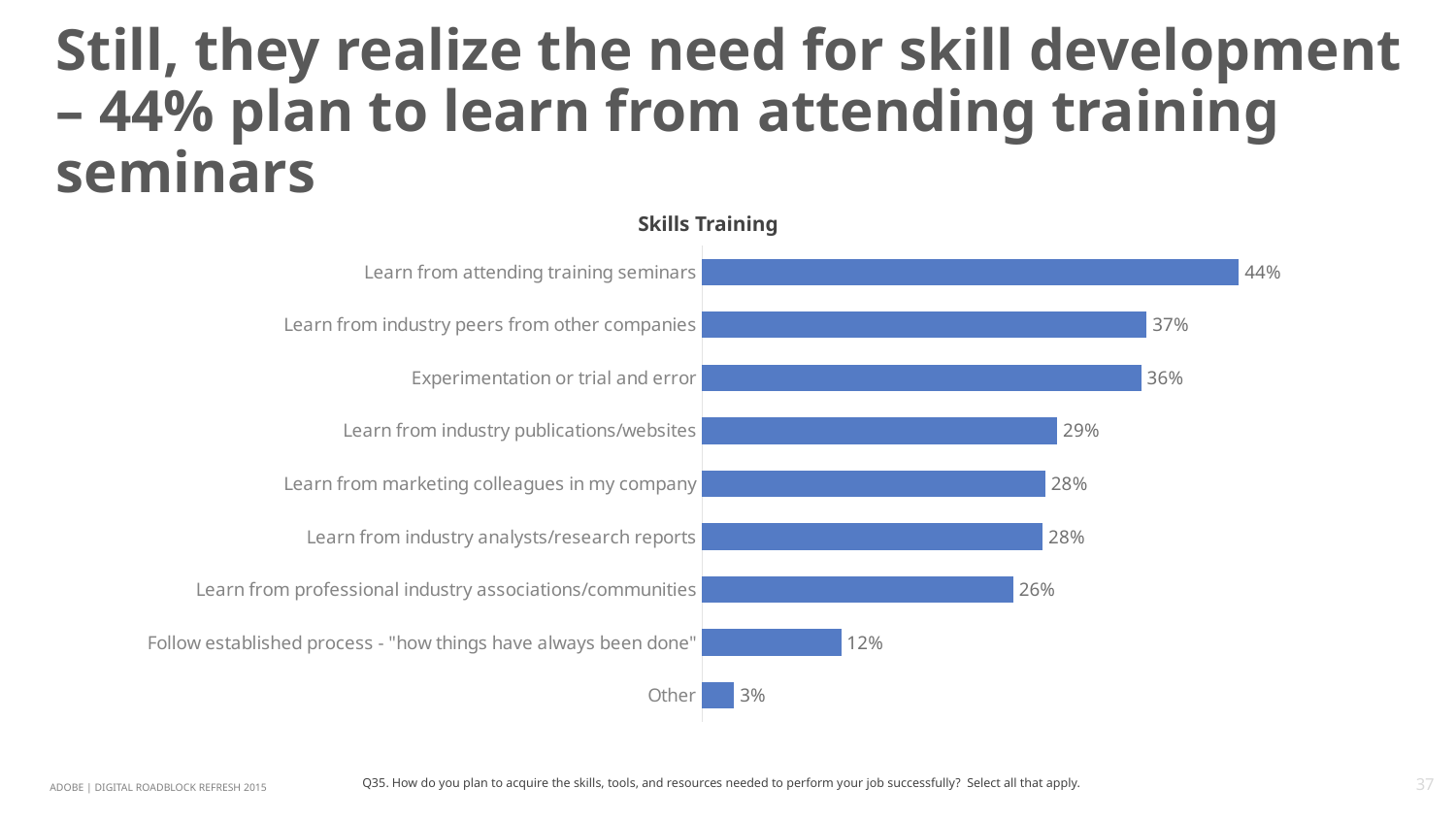
What is the value for "Follow established process - "how things have always been done""? 12% What is the title of the chart? Skills Training What is the difference between "Learn from industry publications/websites" and "Other"? 26% How many categories are shown in the chart? 9 Which two categories both have a value of 28%? Learn from marketing colleagues in my company; Learn from industry analysts/research reports What is the difference between "Learn from attending training seminars" and "Learn from industry peers from other companies"? 7% What percentage plan to learn from attending training seminars? 44% Which is larger: "Learn from industry publications/websites" or "Learn from professional industry associations/communities"? Learn from industry publications/websites Which category has the highest value? Learn from attending training seminars What kind of chart is shown on the slide? Bar chart What is the value for "Experimentation or trial and error"? 36% Which category has the lowest value? Other